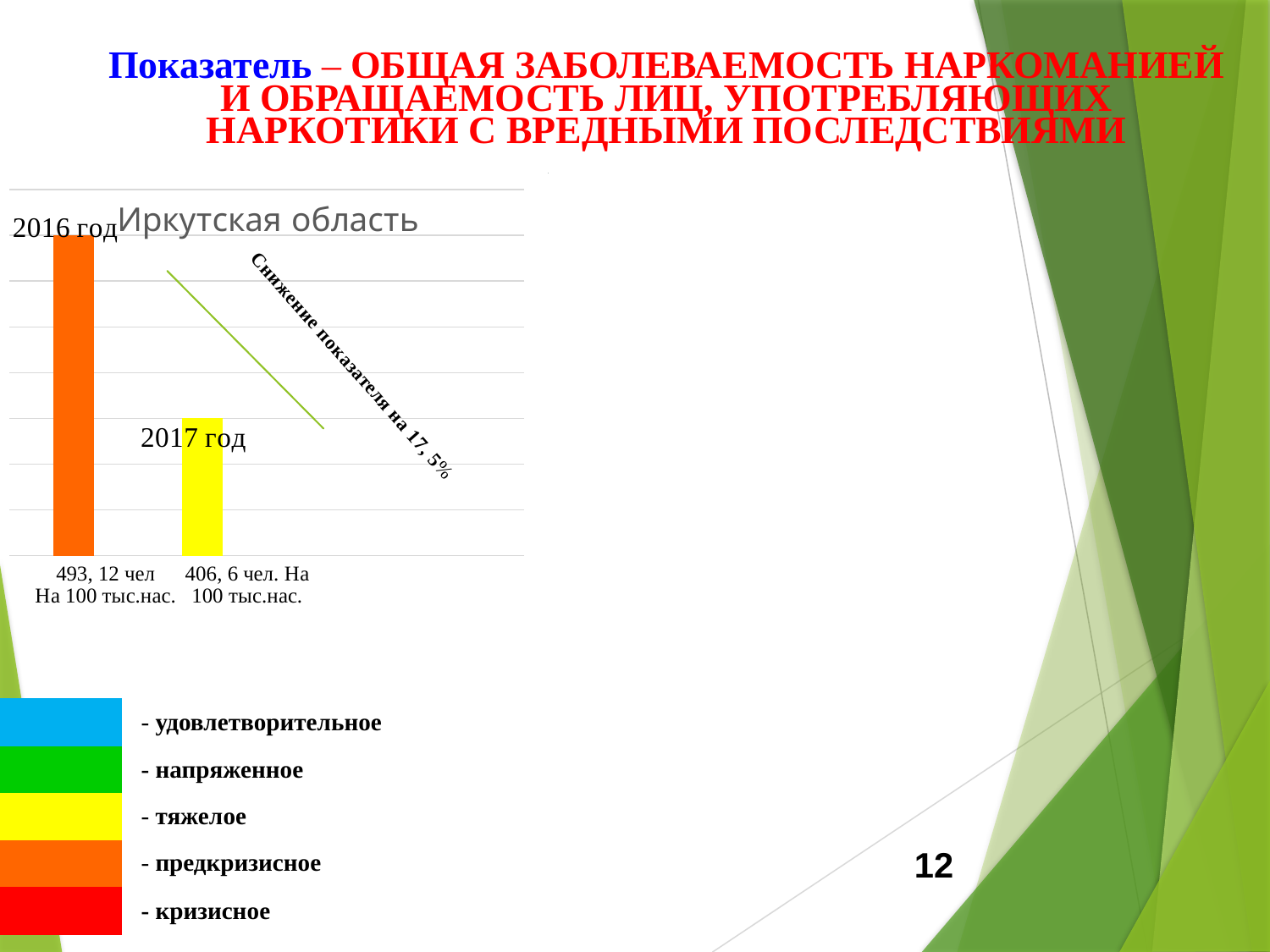
What is the title of the chart on the slide? Иркутская область Which year has the highest bar in the Иркутская область chart? 2016 год How many bars are plotted in the Иркутская область chart? 2 What value is shown for 2017 год in the Иркутская область chart? 406, 6 чел. на 100 тыс.нас. What kind of chart is the Иркутская область chart? bar chart What value is shown for 2016 год in the Иркутская область chart? 493, 12 чел на 100 тыс.нас. By what percentage does the annotation on the chart say the indicator decreased? 17, 5% Does the value rise or fall from 2016 год to 2017 год in the Иркутская область chart? fall Which year has the lowest bar in the Иркутская область chart? 2017 год Which is larger in the Иркутская область chart, the value for 2016 год or for 2017 год? 2016 год